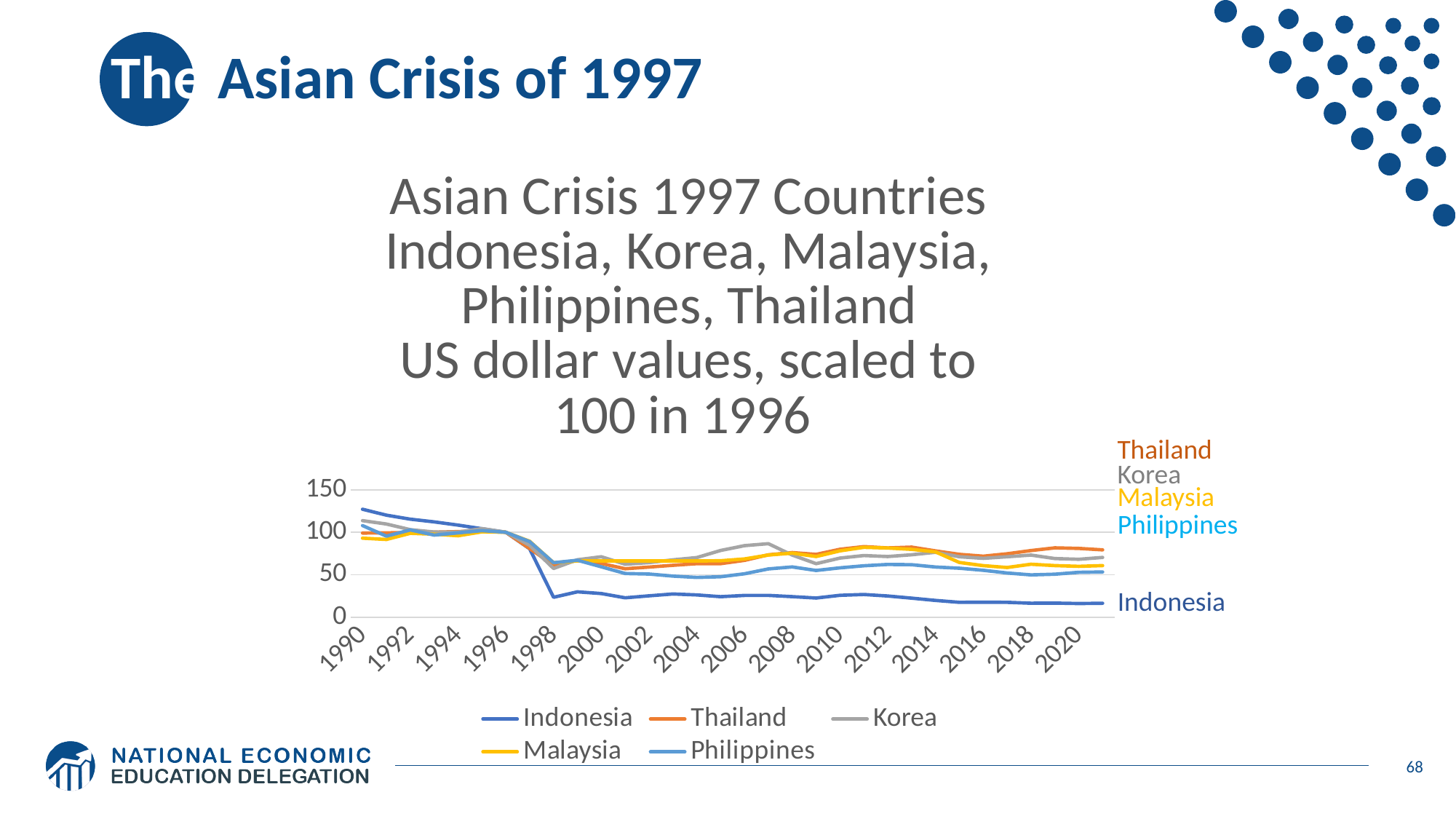
Which countries are listed in the chart legend? Indonesia, Thailand, Korea, Malaysia, Philippines Is the value for Indonesia in 1990 greater or less than 100? greater Does the value for Indonesia rise or fall from 1990 to 2020? fall Which country has the highest value in 1990? Indonesia Is the value for Indonesia in 2020 greater or less than 50? less Which is larger in 2020, the value for Thailand or the value for Indonesia? Thailand What is the value for Indonesia in 1996? 100 What kind of chart is shown on the slide? line chart Which country has the lowest value in 2020? Indonesia How many series does the legend list? 5 Is the value for Thailand in 2020 greater or less than 50? greater According to the chart title, to what value are the series scaled in 1996? 100